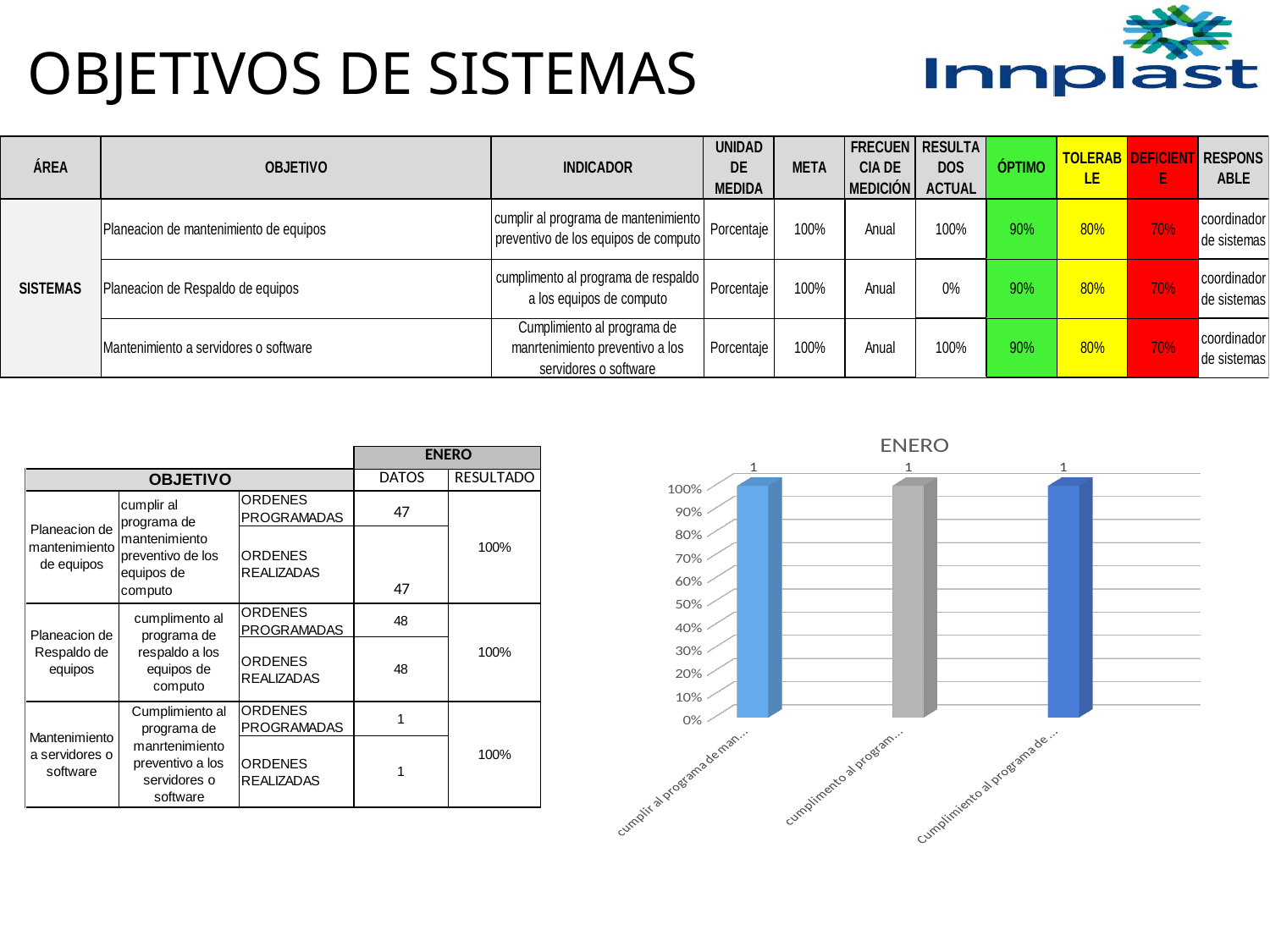
What is the difference between the data label of the first bar and the data label of the third bar in the ENERO chart? 0 What type of chart is shown on the slide? bar chart What data label is shown above the first (leftmost) bar in the ENERO chart? 1 What data label is shown above the third (rightmost) bar in the ENERO chart? 1 What data label is shown above the second (middle) bar in the ENERO chart? 1 In the ENERO chart, is the value of the first bar greater or less than 90%? greater What is the highest value shown on the vertical axis of the ENERO chart? 100% How many bars are plotted in the ENERO chart? 3 Do the bar values in the ENERO chart rise, fall, or stay the same from left to right? stay the same What is the title of the chart on the slide? ENERO In the ENERO chart, is the value of the middle bar greater or less than 50%? greater